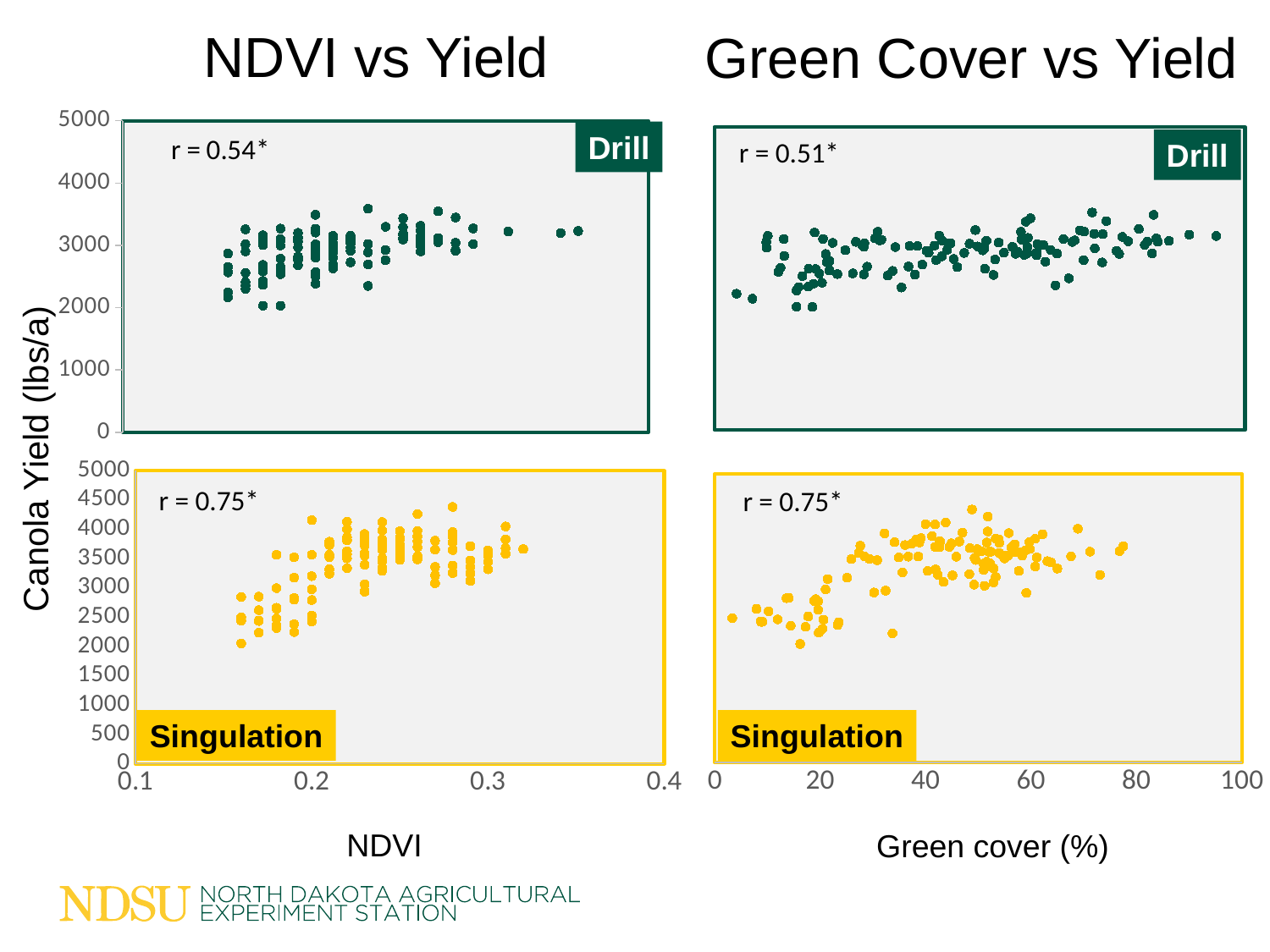
In the Green Cover vs Yield charts, which treatment has the lower correlation coefficient, Drill or Singulation? Drill In the NDVI vs Yield Singulation chart, does canola yield generally rise or fall as NDVI increases? rise In the Green Cover vs Yield Singulation chart, is the lowest plotted yield greater or less than 2500? less In the NDVI vs Yield charts, which treatment has the higher correlation coefficient, Drill or Singulation? Singulation What is the y-axis label shared by the charts on the slide? Canola Yield (lbs/a) In the NDVI vs Yield Drill chart, what is the printed correlation coefficient r? 0.54 What kind of chart is used in the NDVI vs Yield Drill panel? scatter plot In the Green Cover vs Yield Drill chart, what is the printed correlation coefficient r? 0.51 In the NDVI vs Yield Singulation chart, what is the printed correlation coefficient r? 0.75 How many scatter plots are shown on the slide? 4 In the Green Cover vs Yield Singulation chart, what is the printed correlation coefficient r? 0.75 In the NDVI vs Yield Drill chart, is the highest plotted yield greater or less than 4000? less